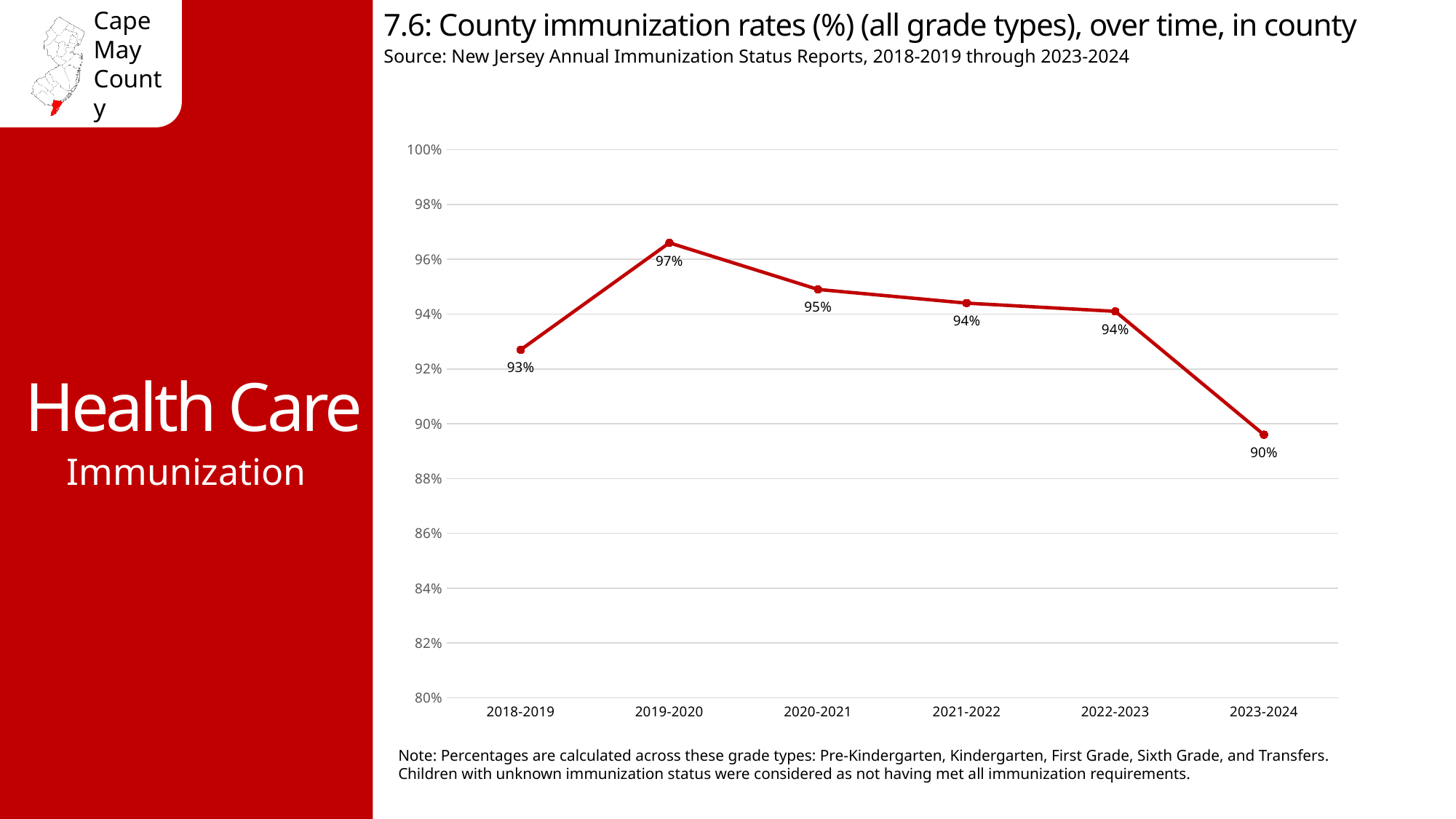
What is the county immunization rate for 2019-2020? 97% Which school year has the lowest immunization rate? 2023-2024 What is the county immunization rate for 2020-2021? 95% What is the county immunization rate for 2018-2019? 93% How many school years are plotted on the chart? 6 Is the immunization rate for 2023-2024 greater or less than 92%? less What kind of chart is shown on the slide? Line chart Which school year has the highest immunization rate? 2019-2020 What is the county immunization rate for 2023-2024? 90% Which is larger, the immunization rate in 2018-2019 or in 2020-2021? 2020-2021 What is the difference between the immunization rate in 2019-2020 and in 2023-2024? 7 percentage points Does the immunization rate rise or fall from 2019-2020 to 2023-2024? Fall